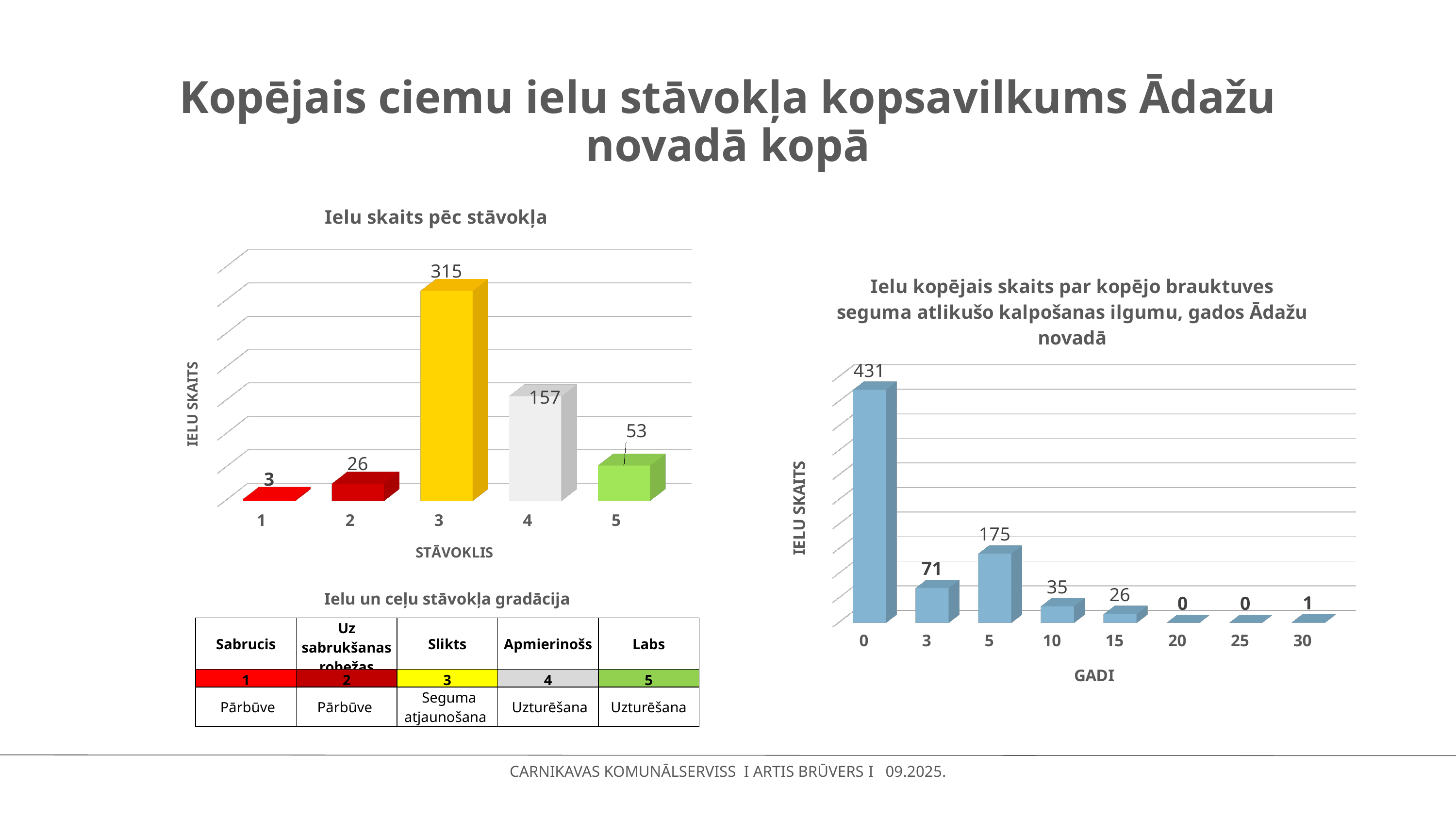
In the chart 'Ielu skaits pēc stāvokļa', what is the value for category 3? 315 In the chart 'Ielu skaits pēc stāvokļa', how many categories are shown on the x axis? 5 In the chart 'Ielu skaits pēc stāvokļa', what is the difference between the values for categories 3 and 4? 158 What type of chart is the chart on the right? Bar chart In the chart 'Ielu skaits pēc stāvokļa', what colour is the bar for category 3? Yellow In the chart on the right, what is the value for 10 years (GADI)? 35 In the chart 'Ielu skaits pēc stāvokļa', which category has the lowest value? 1 In the chart 'Ielu skaits pēc stāvokļa', what is the value for category 5? 53 In the chart on the right, which is larger: the value for 3 years or the value for 5 years? 5 years In the chart on the right, which GADI category has the highest value? 0 In the chart on the right, what is the difference between the values for 5 years and 15 years? 149 In the chart on the right ('Ielu kopējais skaits par kopējo brauktuves seguma atlikušo kalpošanas ilgumu'), what is the value for 0 years (GADI)? 431